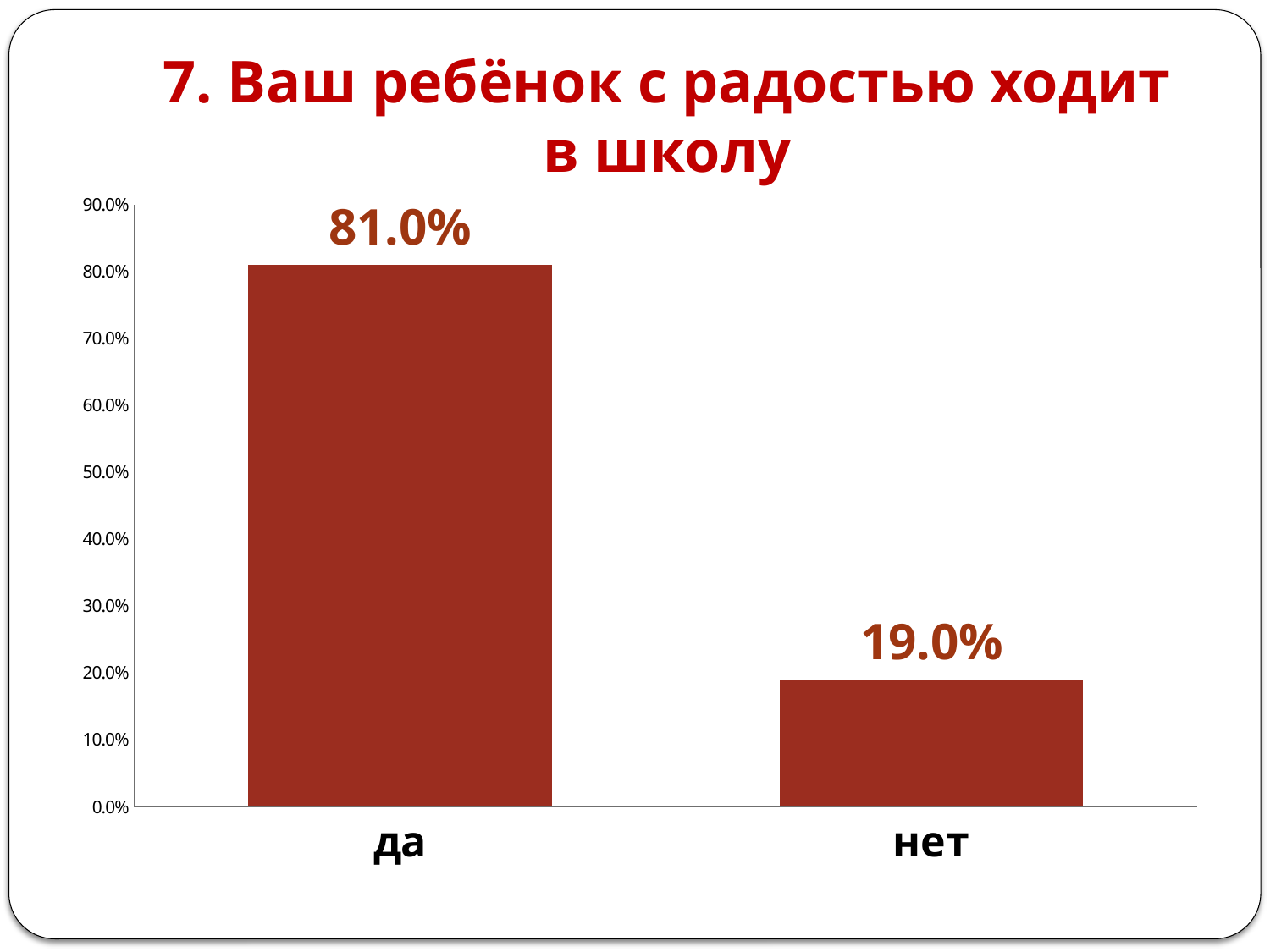
Which category has the highest value? да Is the value for "нет" greater or less than 20.0%? less Which category has the lowest value? нет What is the value for "нет"? 19.0% What is the value for "да"? 81.0% What is the title of the chart? 7. Ваш ребёнок с радостью ходит в школу What kind of chart is shown on the slide? bar chart Is the value for "да" greater or less than 80.0%? greater What is the highest value shown on the y axis? 90.0% How many categories are shown on the x axis? 2 What is the difference between the values for "да" and "нет"? 62.0% Which is larger, the value for "да" or the value for "нет"? да